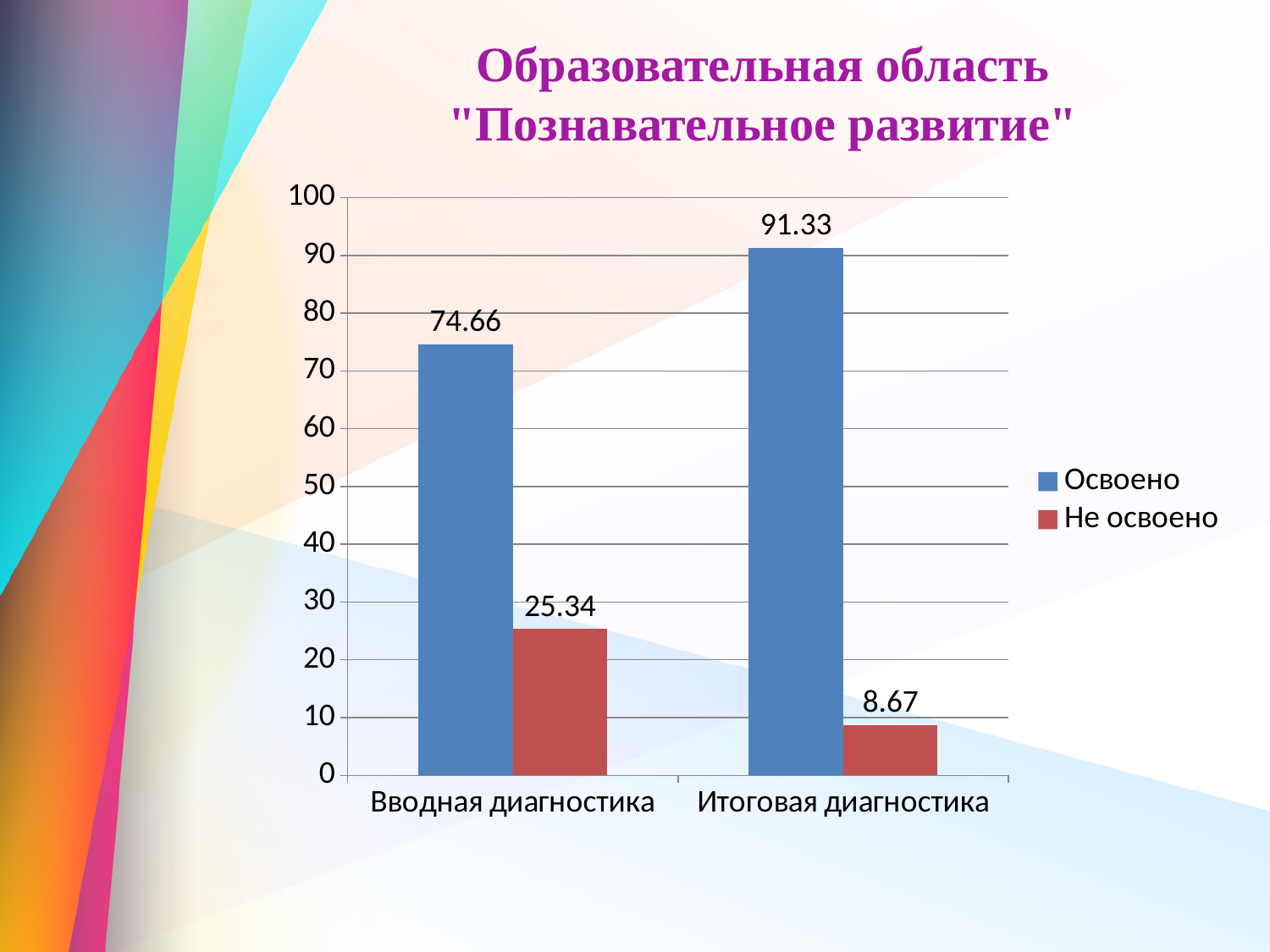
What is the value of Не освоено for Вводная диагностика? 25.34 How many categories are shown on the x axis? 2 Which category has the highest Освоено value? Итоговая диагностика Which category has the lowest Не освоено value? Итоговая диагностика What is the value of Освоено for Вводная диагностика? 74.66 Does the Освоено value rise or fall from Вводная диагностика to Итоговая диагностика? Rise How many series does the legend list? 2 Which is larger: Не освоено for Вводная диагностика or Не освоено for Итоговая диагностика? Вводная диагностика What is the value of Не освоено for Итоговая диагностика? 8.67 What kind of chart is shown on the slide? Bar chart What is the difference between the Освоено values for Итоговая диагностика and Вводная диагностика? 16.67 What is the value of Освоено for Итоговая диагностика? 91.33